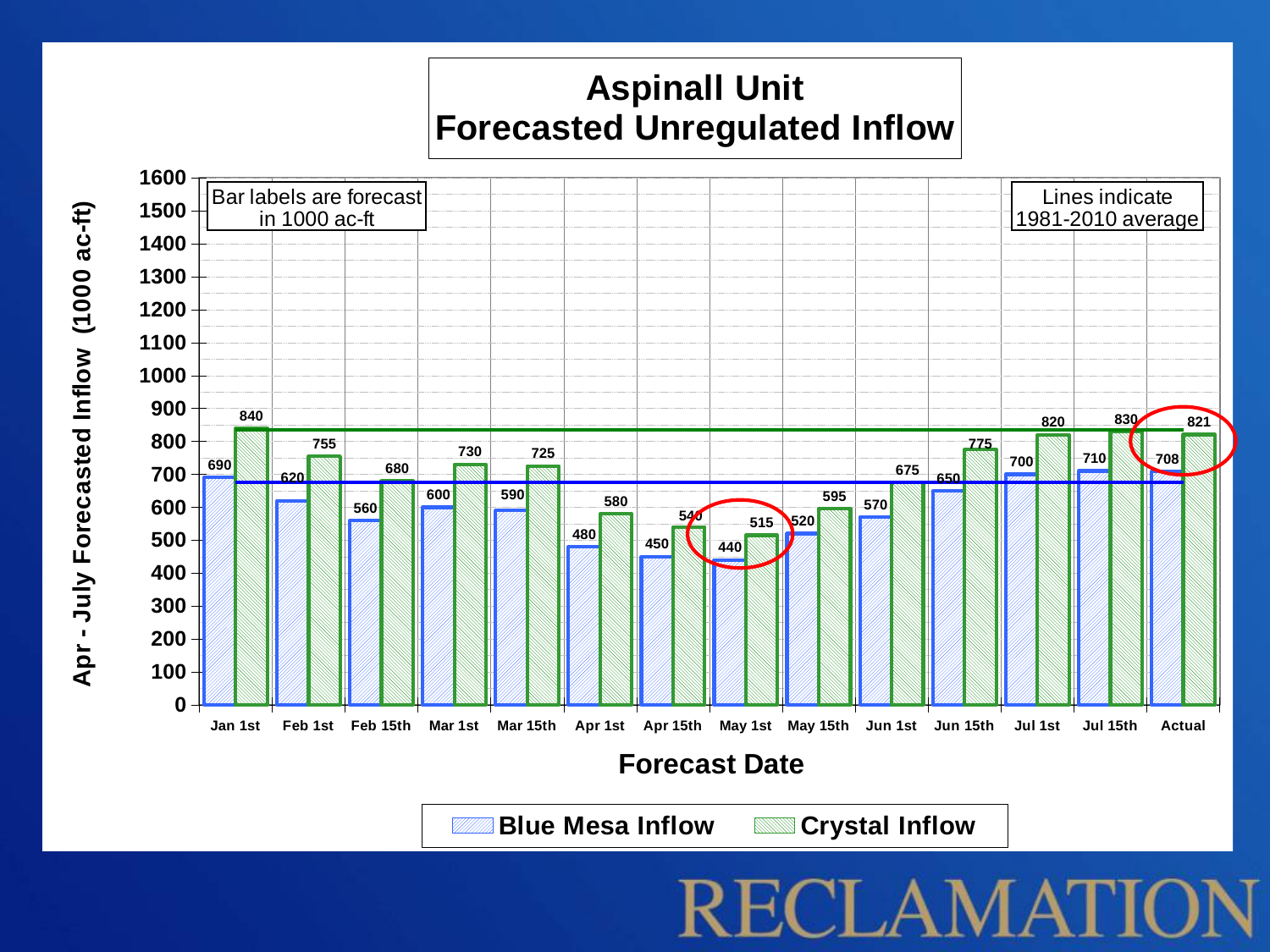
From May 1st to Jul 15th, do the Blue Mesa Inflow forecasts rise or fall? rise On which forecast date is the Blue Mesa Inflow forecast lowest? May 1st What kind of chart is shown on the slide? bar chart How many forecast dates (categories) are shown on the x axis? 14 Which is larger for Blue Mesa Inflow: the Jul 15th forecast or the Actual value? Jul 15th What is the difference between the Crystal Inflow and Blue Mesa Inflow forecasts on Jan 1st? 150 How many series does the legend list? 2 On which forecast date is the Crystal Inflow forecast highest? Jan 1st What is the Crystal Inflow value for the Actual category? 821 What is the Blue Mesa Inflow forecast for Jan 1st? 690 What is the title of the chart? Aspinall Unit Forecasted Unregulated Inflow Is the Crystal Inflow value for Jun 15th greater or less than 700? greater